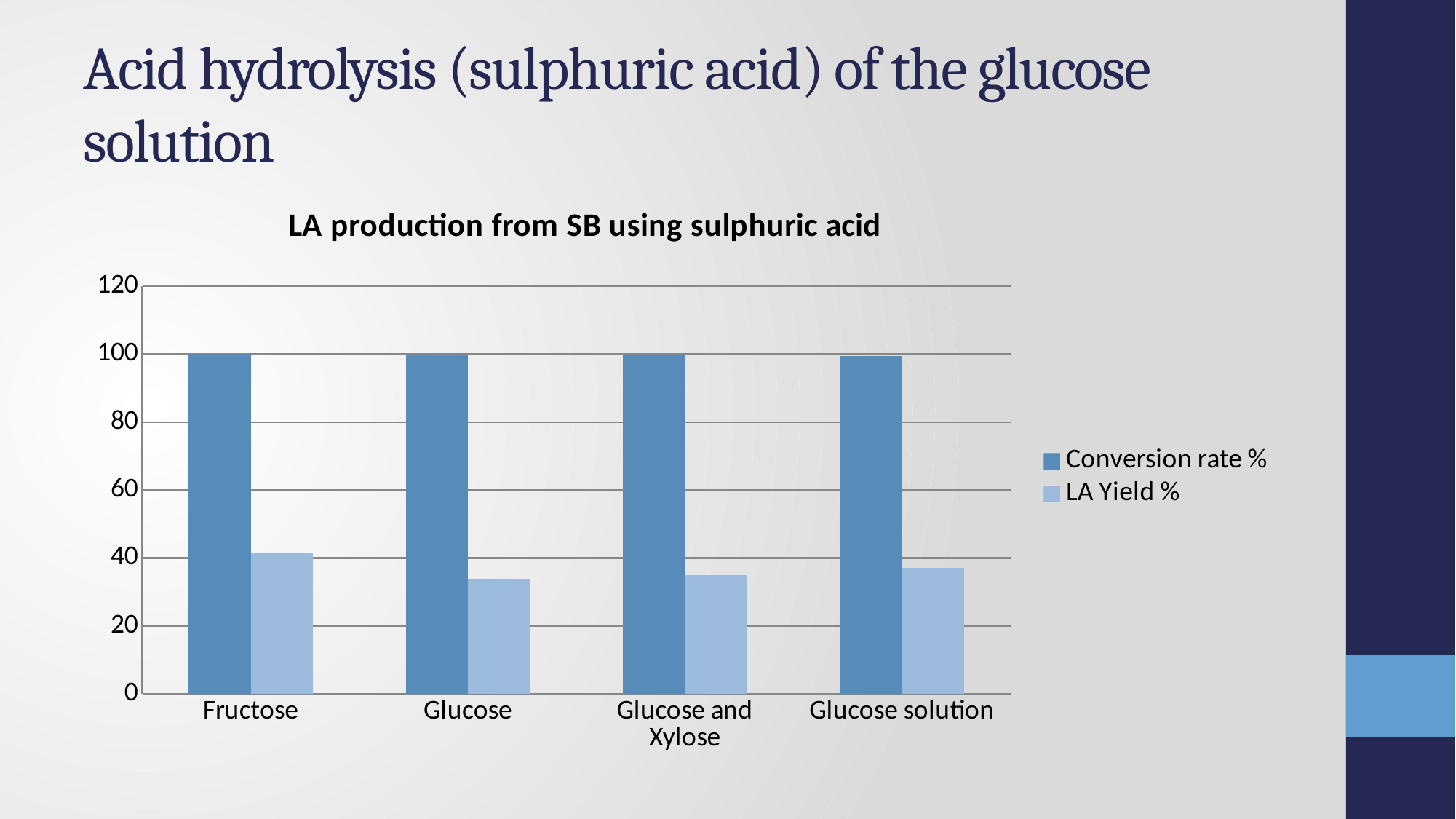
Which is larger, the LA Yield % for Fructose or the LA Yield % for Glucose? Fructose Which category has the highest LA Yield %? Fructose For Glucose solution, which is larger, the Conversion rate % or the LA Yield %? Conversion rate % How many series does the legend list? 2 Which series is shown in the lighter blue colour? LA Yield % How many categories are shown on the x axis? 4 Is the LA Yield % for Fructose greater or less than 20? greater What is the title of the chart? LA production from SB using sulphuric acid What kind of chart is shown on the slide? bar chart Is the LA Yield % for Glucose solution greater or less than 60? less Is the LA Yield % for Glucose greater or less than 40? less